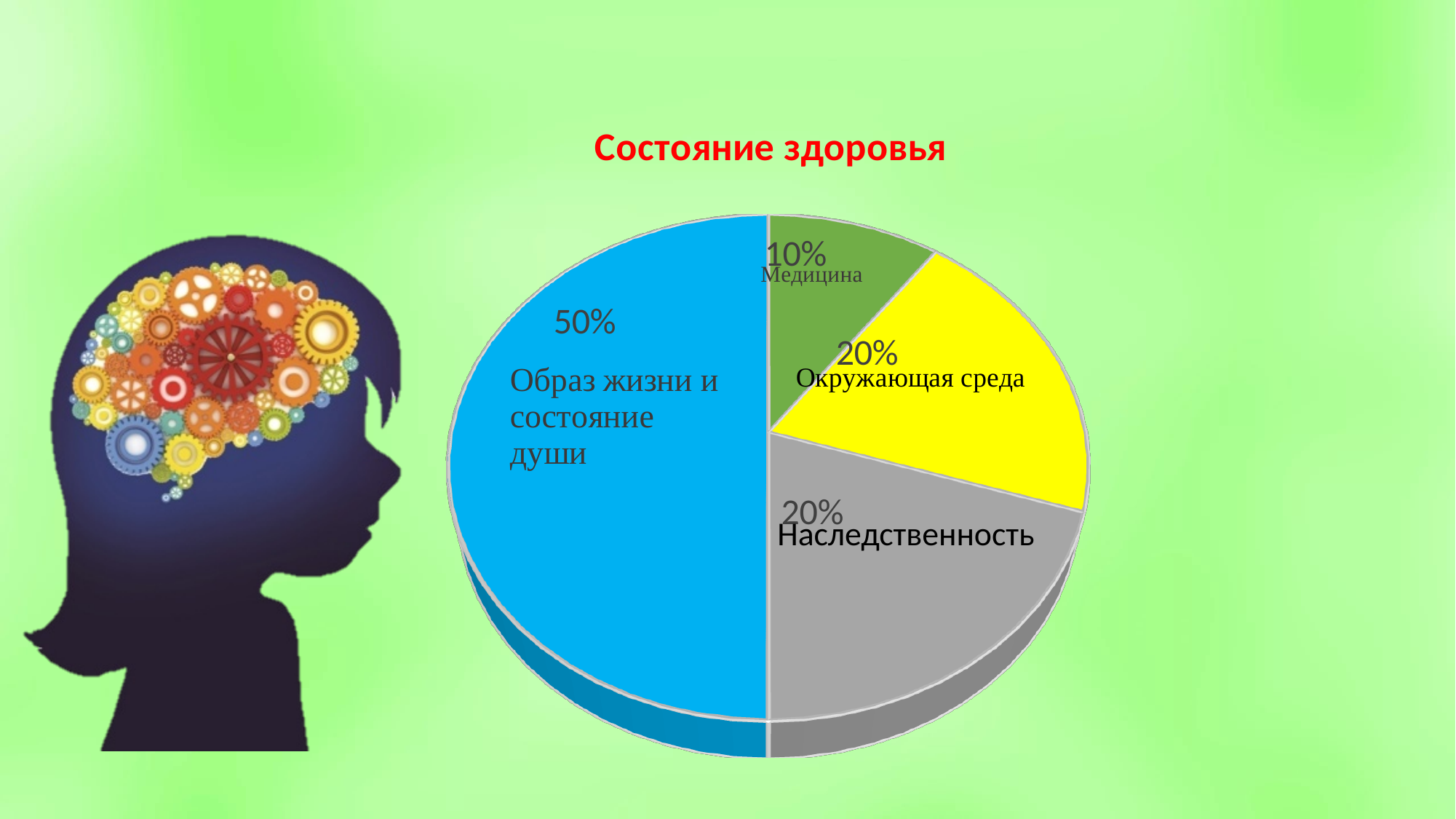
What kind of chart is shown on the slide? pie chart What share of the pie does Образ жизни и состояние души take? 50% Which is larger, the share for Окружающая среда or the share for Медицина? Окружающая среда How many slices does the pie chart have? 4 What is the title of the chart? Состояние здоровья Which slice of the pie is the smallest? Медицина Which slice of the pie is the largest? Образ жизни и состояние души What share of the pie does Наследственность take? 20% What share of the pie does Окружающая среда take? 20% What is the difference between the share for Образ жизни и состояние души and the share for Медицина? 40% What colour is the slice for Наследственность? gray What share of the pie does Медицина take? 10%